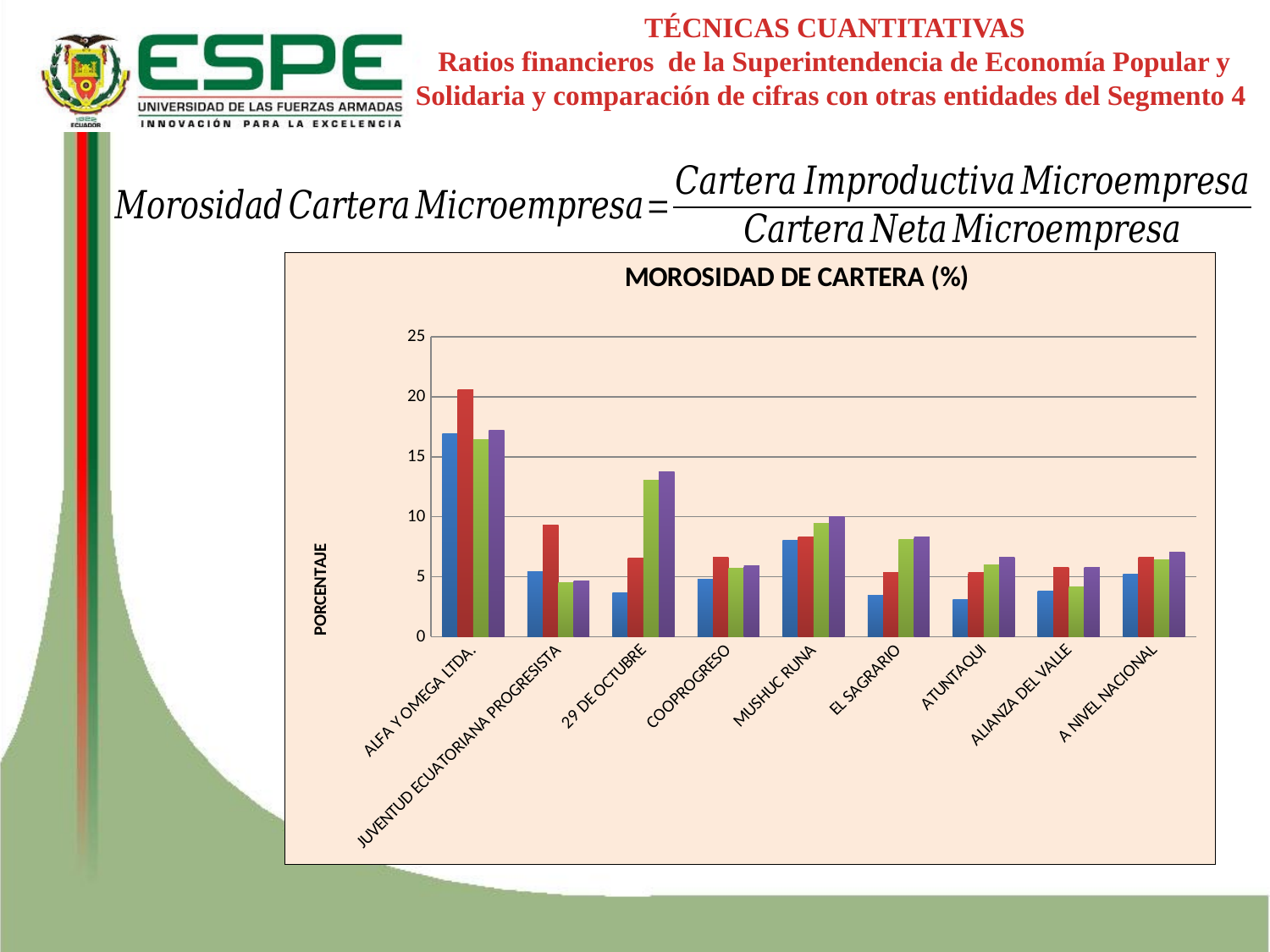
What is the label on the vertical axis of the chart? PORCENTAJE How many bars are plotted for each category in the chart? 4 What kind of chart is shown on the slide? bar chart For 29 DE OCTUBRE, which is larger: the red bar or the green bar? the green bar What is the title of the chart? MOROSIDAD DE CARTERA (%) Which category has the tallest bar in the chart? ALFA Y OMEGA LTDA. How many categories are shown along the x axis of the chart? 9 Which is larger: the blue bar for ALFA Y OMEGA LTDA. or the blue bar for JUVENTUD ECUATORIANA PROGRESISTA? ALFA Y OMEGA LTDA. Is the green bar for 29 DE OCTUBRE greater or less than 10? greater Is the blue bar for ALFA Y OMEGA LTDA. greater or less than 15? greater Is the blue bar for ATUNTAQUI greater or less than 5? less